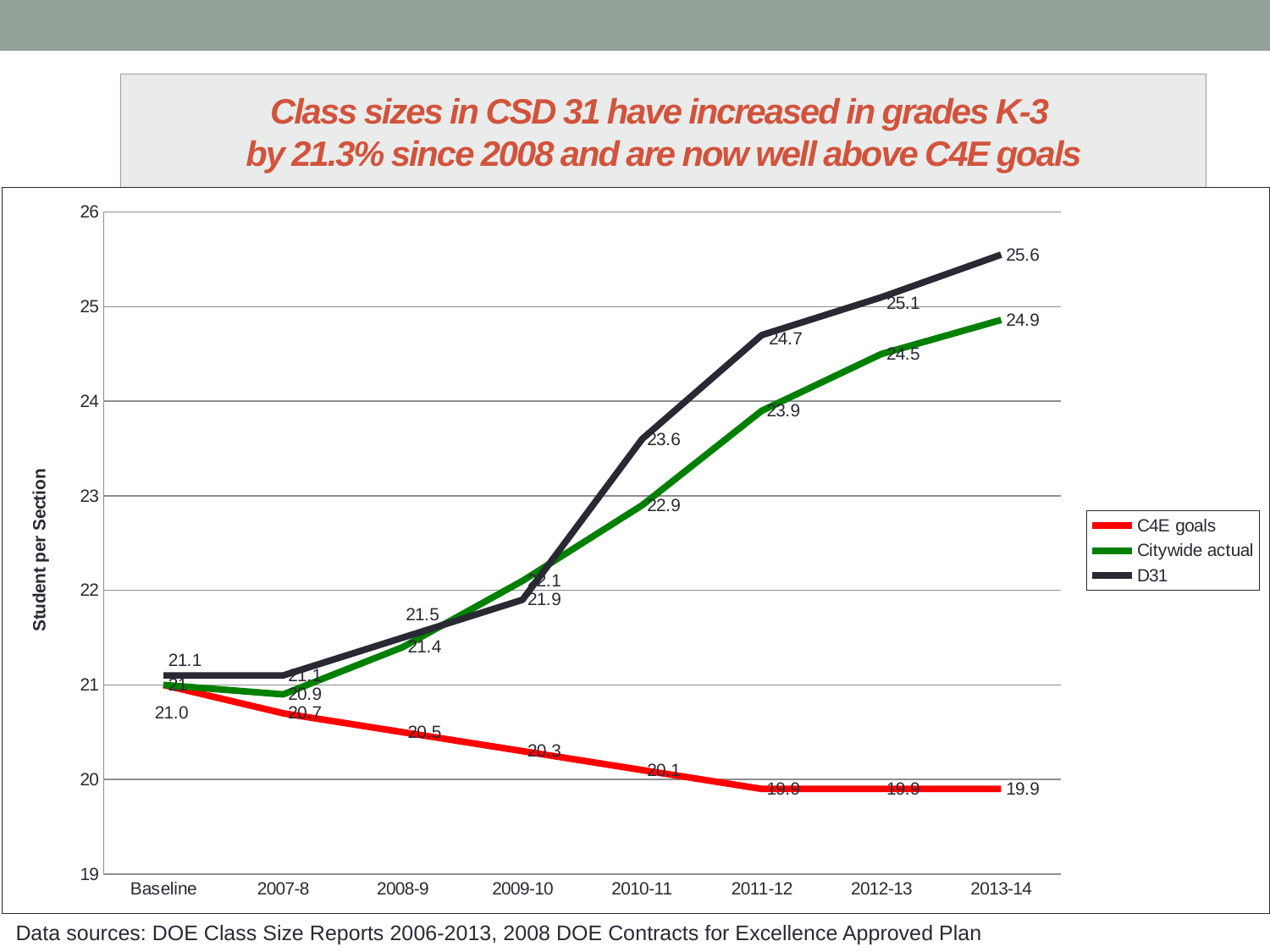
Does the C4E goals series rise or fall from Baseline to 2013-14? fall What is the Citywide actual value for 2013-14? 24.9 What is the difference between the D31 value and the C4E goals value in 2013-14? 5.7 What is the title of the y axis? Student per Section What kind of chart is shown on the slide? line chart What is the C4E goals value for 2013-14? 19.9 In which year does the D31 series reach its highest value? 2013-14 In 2010-11, which is larger: the D31 value or the Citywide actual value? D31 How many series does the legend list? 3 Does the D31 series rise or fall from Baseline to 2013-14? rise What is the D31 value for 2013-14? 25.6 How many points are plotted along the x axis for each series? 8